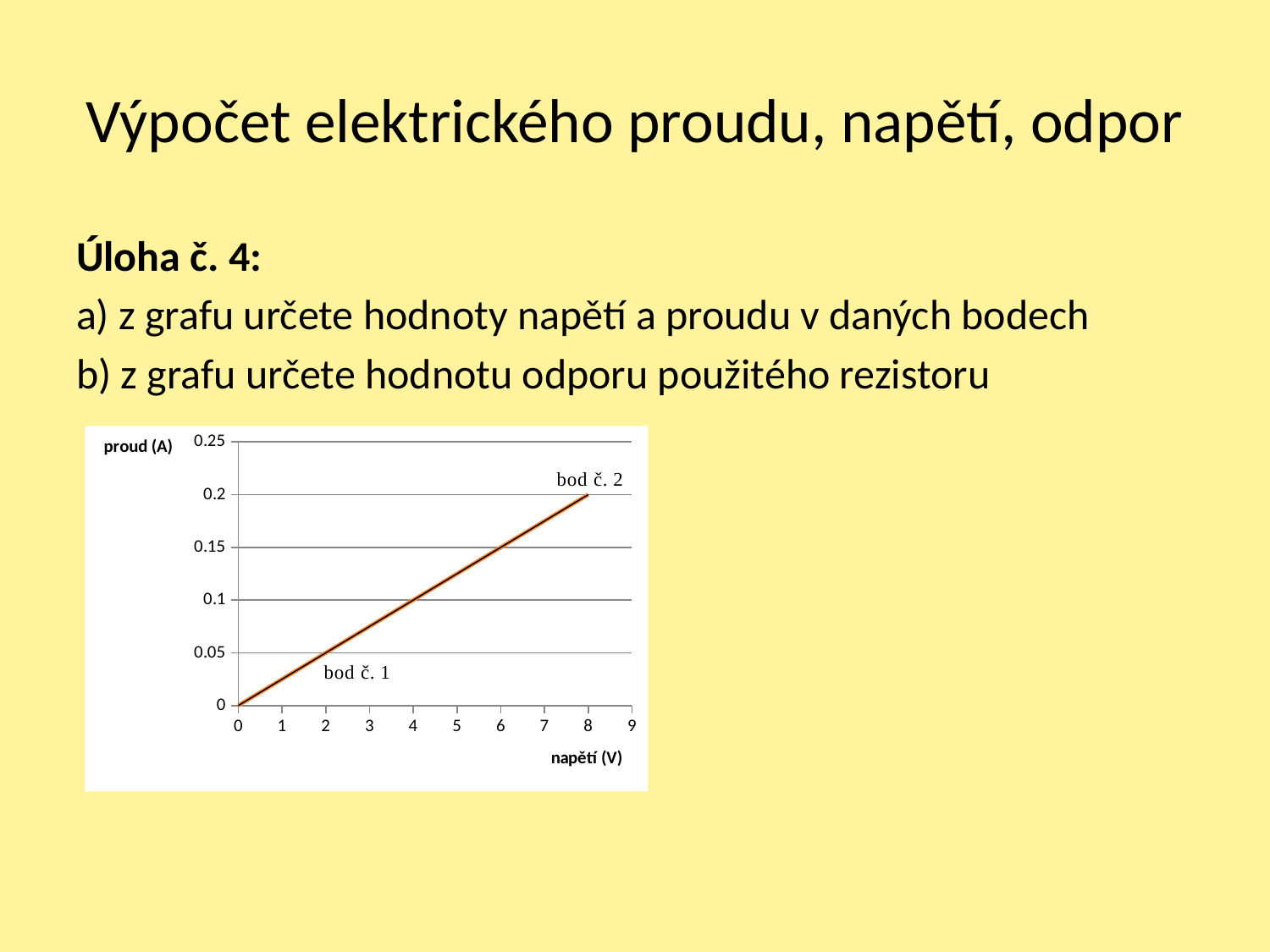
What is the voltage (napětí) at the point labelled bod č. 2? 8 What is the difference in current between bod č. 2 and bod č. 1? 0.15 How many labelled points are marked on the line? 2 Which labelled point has the higher current, bod č. 1 or bod č. 2? bod č. 2 What is the current (proud) at the point labelled bod č. 1? 0.05 What is the label of the vertical axis of the chart? proud (A) Is the current at a voltage of 6 V greater or less than 0.1? greater What is the label of the horizontal axis of the chart? napětí (V) What kind of chart is shown on the slide? line chart What is the current (proud) at the point labelled bod č. 2? 0.2 Does the current rise or fall as the voltage increases along the x axis? rise What is the voltage (napětí) at the point labelled bod č. 1? 2